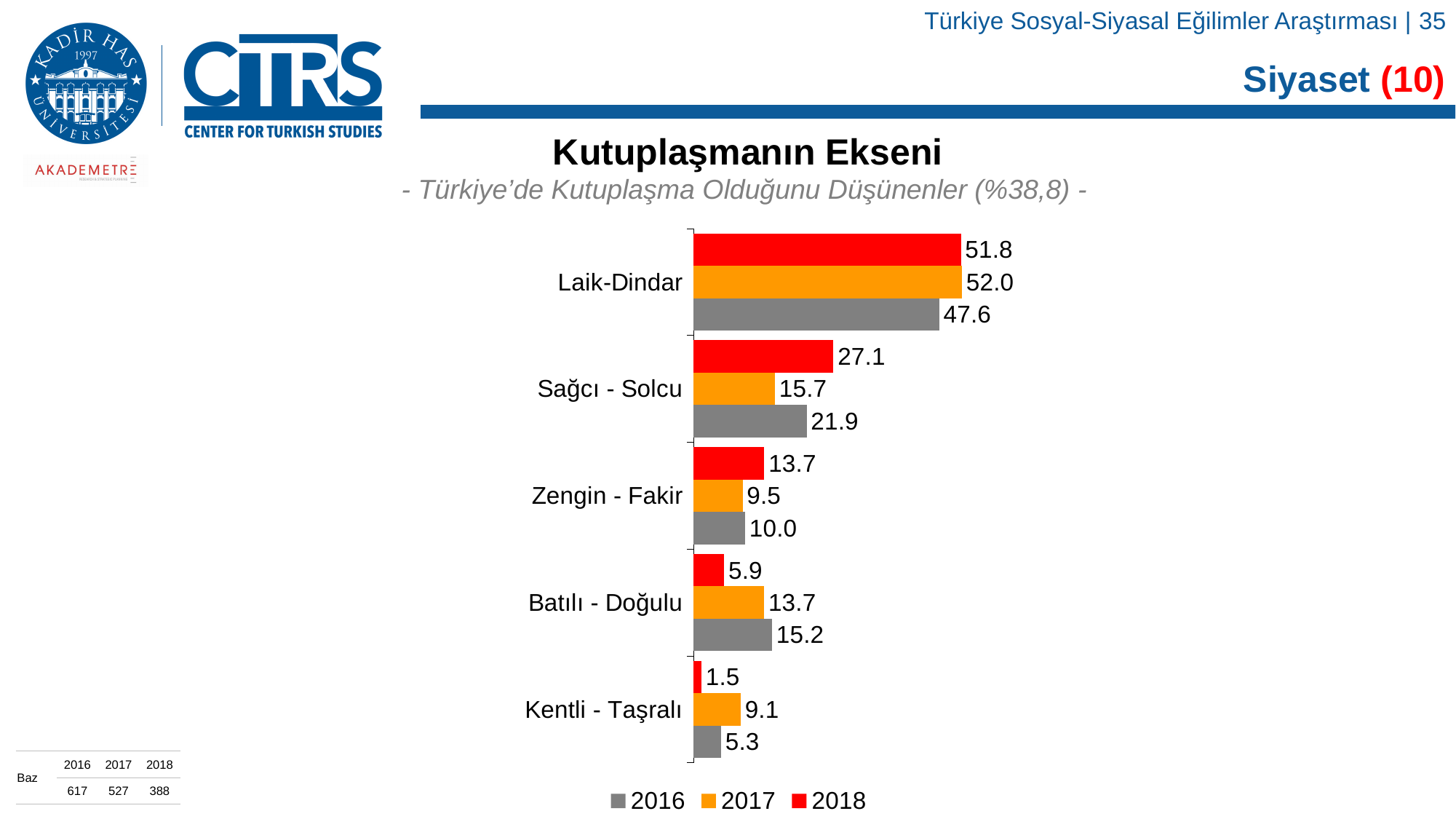
What is the 2018 value for Sağcı - Solcu? 27.1 How many series does the legend list? 3 Which is larger for Batılı - Doğulu: the 2016 value or the 2018 value? 2016 What is the difference between the 2017 and 2016 values for Zengin - Fakir? 0.5 What kind of chart is shown on the slide? Bar chart What is the 2016 value for Laik-Dindar? 47.6 How many categories are shown on the chart? 5 Which category has the highest 2018 value? Laik-Dindar What is the 2017 value for Kentli - Taşralı? 9.1 Which category has the lowest 2018 value? Kentli - Taşralı Which colour represents the 2018 series in the legend? Red What is the difference between the 2018 and 2017 values for Sağcı - Solcu? 11.4